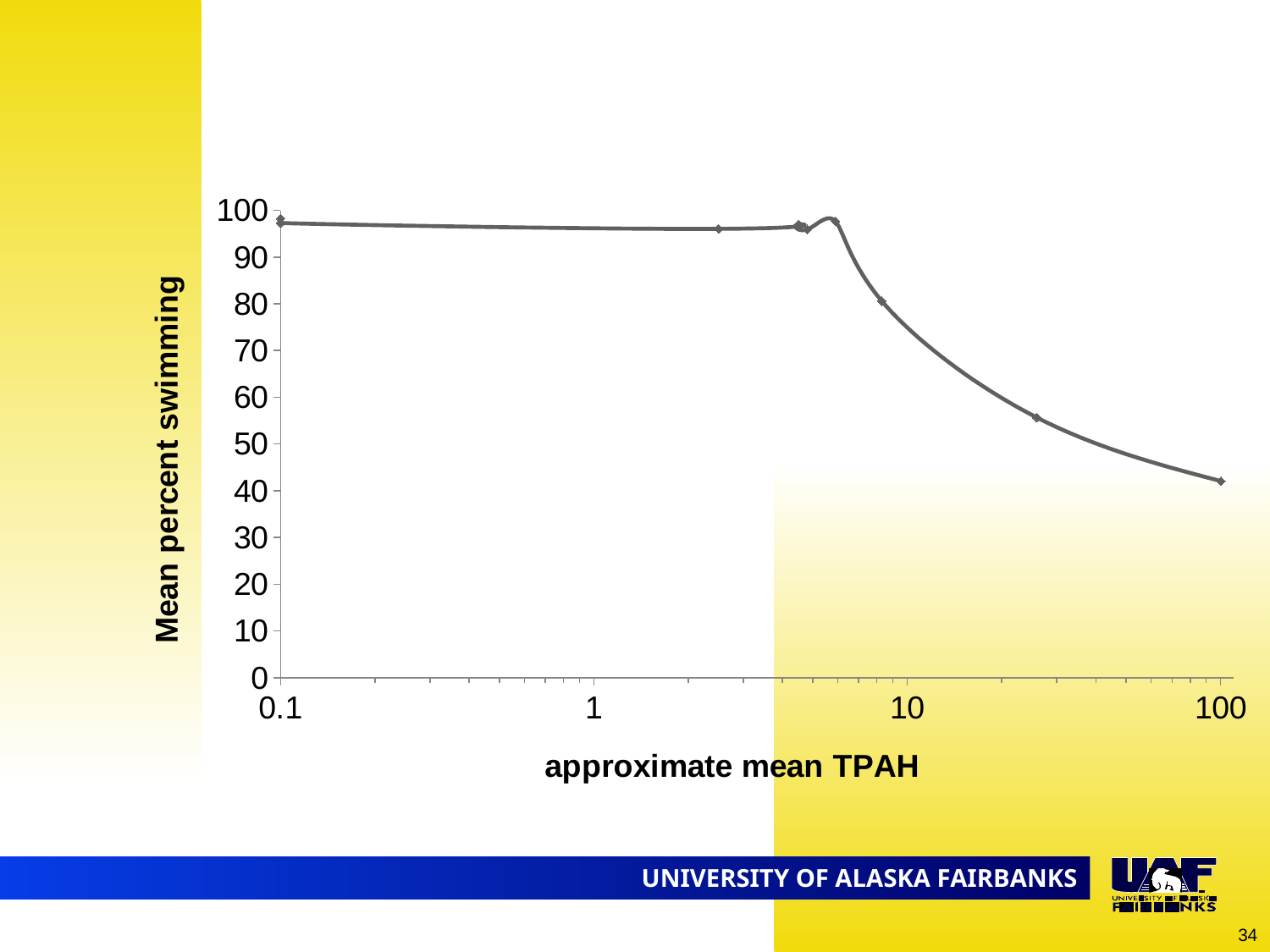
Which has the higher mean percent swimming: an approximate mean TPAH of 0.1 or of 100? 0.1 Is the mean percent swimming at an approximate mean TPAH of 10 greater or less than 90? less Is the mean percent swimming at an approximate mean TPAH of 100 greater or less than 50? less What is the label of the x axis? approximate mean TPAH Which has the higher mean percent swimming: an approximate mean TPAH of 1 or of 10? 1 Overall, does mean percent swimming rise or fall as approximate mean TPAH increases along the x axis? fall What is the label of the y axis? Mean percent swimming Is the mean percent swimming at an approximate mean TPAH of 100 greater or less than 30? greater What kind of chart is shown on the slide? line chart At which approximate mean TPAH value shown on the x axis is mean percent swimming lowest? 100